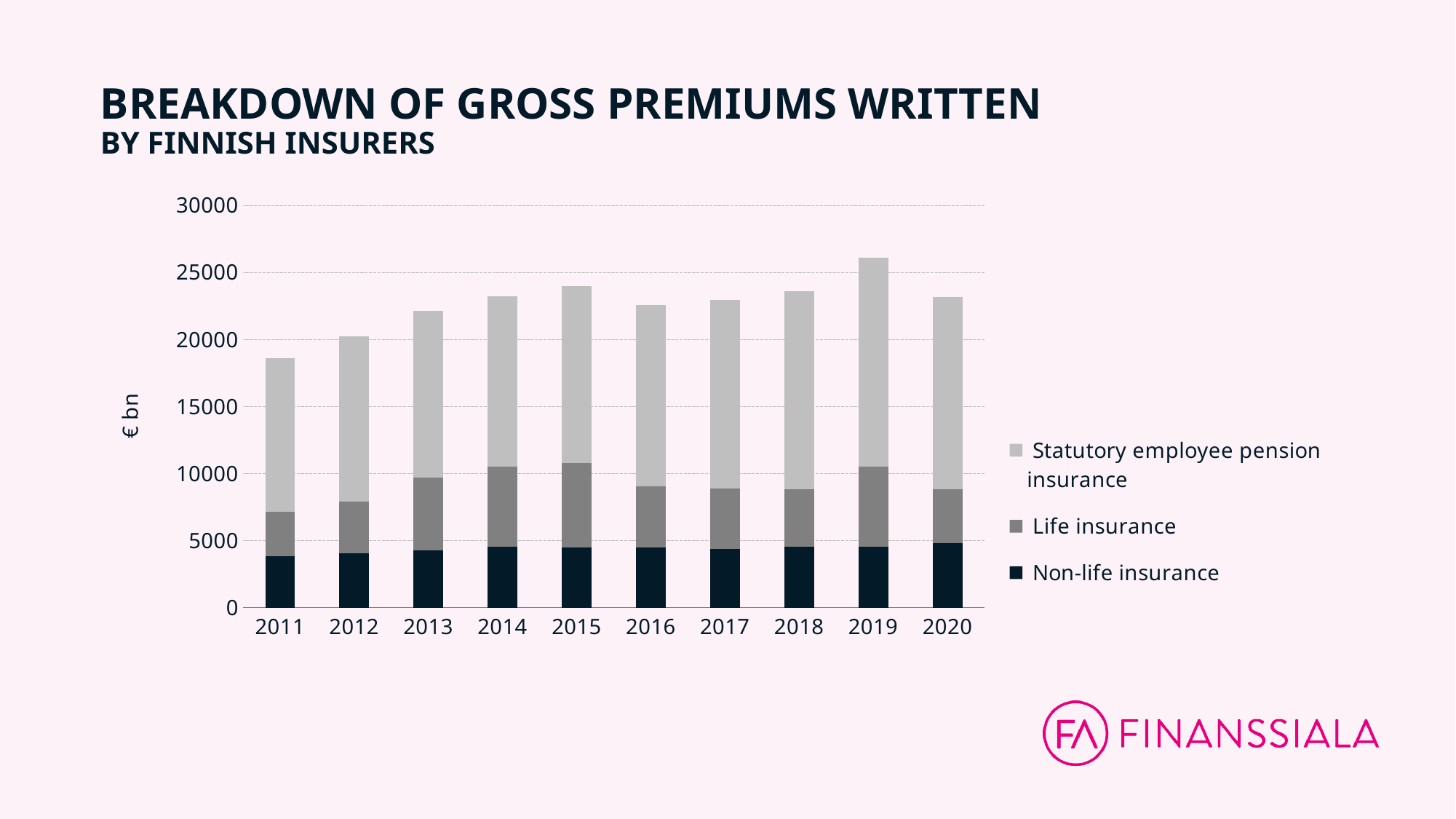
Which series is shown in the darkest colour at the bottom of each bar? Non-life insurance How many years are shown on the x axis of the chart? 10 Do the total gross premiums written rise or fall from 2011 to 2015? rise What unit is shown on the y axis of the chart? € bn Which year has the larger total bar, 2012 or 2013? 2013 How many series does the chart's legend list? 3 Is the total bar for 2011 greater or less than 20000? less What kind of chart is shown on the slide? Stacked bar chart Which year has the lowest total gross premiums written? 2011 Is the total bar for 2019 greater or less than 25000? greater Which year has the highest total gross premiums written? 2019 Is the total bar for 2015 greater or less than 20000? greater